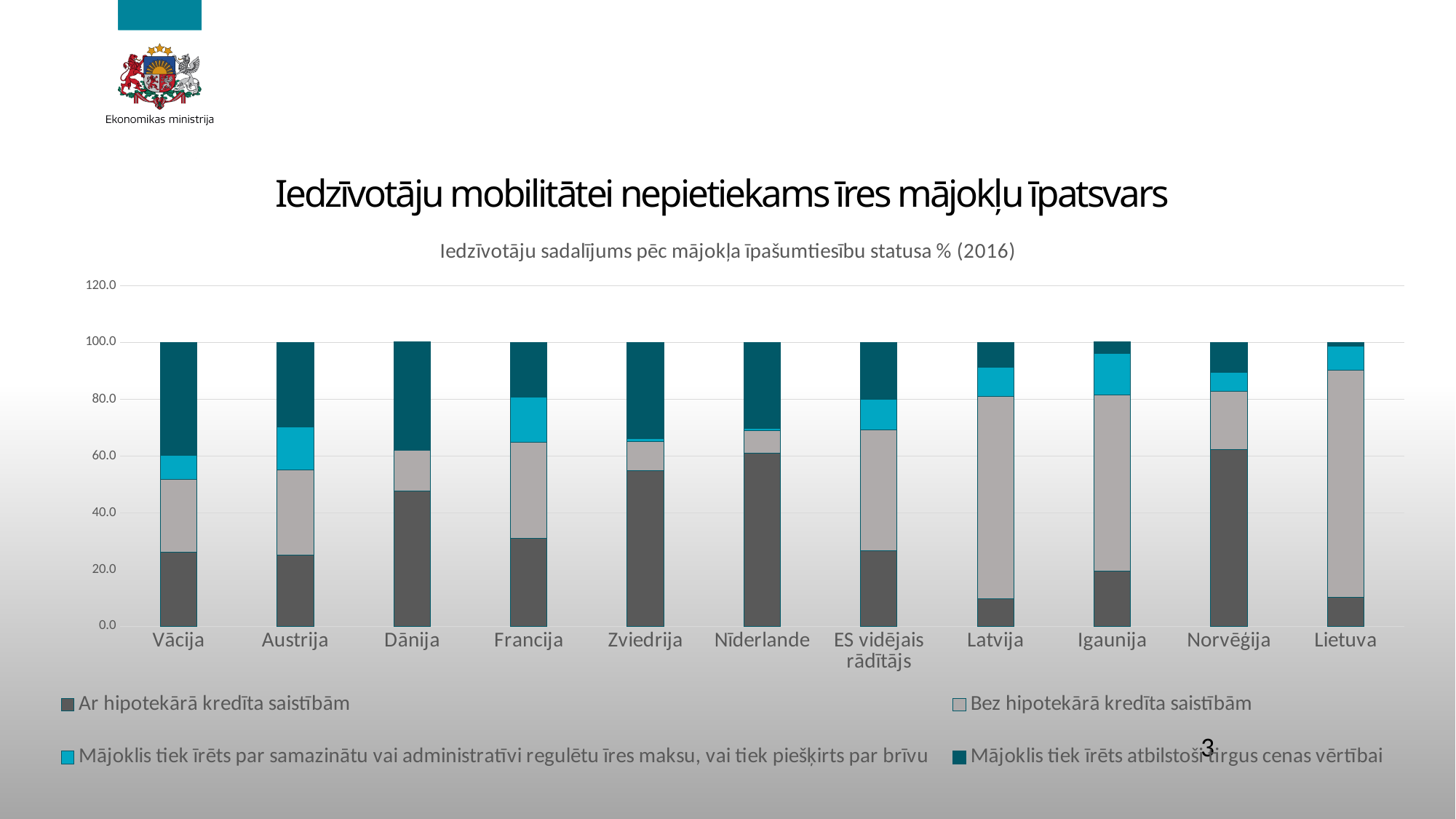
How many series does the chart legend list? 4 Is the value for 'Ar hipotekārā kredīta saistībām' in Lietuva greater or less than 20? less Is the value for 'Ar hipotekārā kredīta saistībām' in Latvija greater or less than 20? less What is the title of the chart? Iedzīvotāju sadalījums pēc mājokļa īpašumtiesību statusa % (2016) Is the value for 'Ar hipotekārā kredīta saistībām' in Norvēģija greater or less than 40? greater How many countries/categories are shown on the x axis of the chart? 11 Which has the larger value for 'Ar hipotekārā kredīta saistībām', Vācija or Latvija? Vācija What kind of chart is shown on the slide? Stacked bar chart Which has the larger value for 'Mājoklis tiek īrēts atbilstoši tirgus cenas vērtībai', Vācija or Latvija? Vācija Which legend entry is shown with the dark grey colour? Ar hipotekārā kredīta saistībām